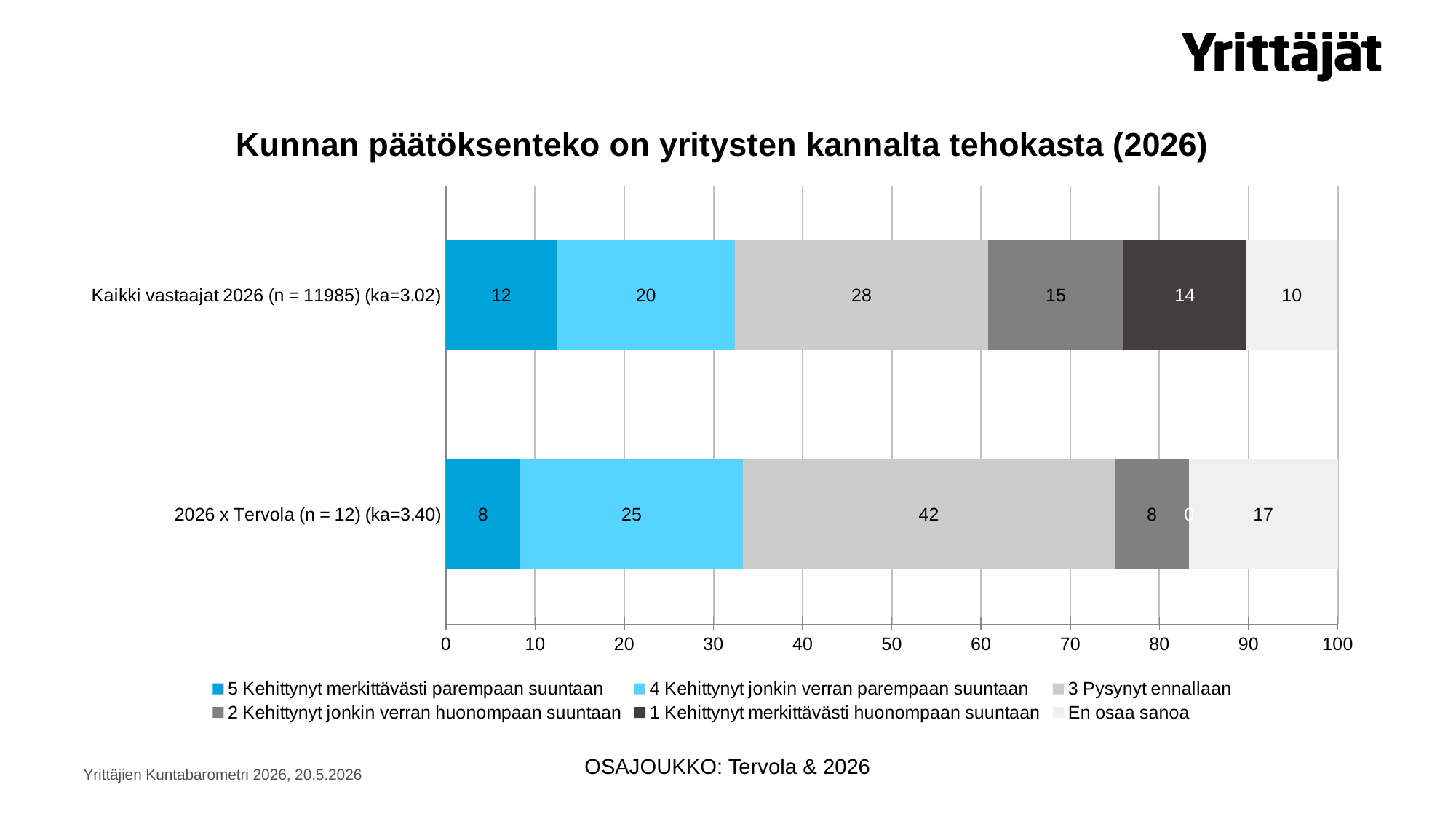
What is the title of the chart? Kunnan päätöksenteko on yritysten kannalta tehokasta (2026) Which segment is the largest in the "2026 x Tervola (n = 12) (ka=3.40)" bar? 3 Pysynyt ennallaan How many categories (bars) does the chart show? 2 What is the value of "3 Pysynyt ennallaan" for "2026 x Tervola (n = 12) (ka=3.40)"? 42 What is the value of "1 Kehittynyt merkittävästi huonompaan suuntaan" for "Kaikki vastaajat 2026 (n = 11985) (ka=3.02)"? 14 What kind of chart is shown on the slide? Stacked bar chart What is the difference between the "3 Pysynyt ennallaan" values for "2026 x Tervola (n = 12) (ka=3.40)" and "Kaikki vastaajat 2026 (n = 11985) (ka=3.02)"? 14 How many series does the legend list? 6 What is the total of the stacked bar for "Kaikki vastaajat 2026 (n = 11985) (ka=3.02)"? 99 What is the value of "5 Kehittynyt merkittävästi parempaan suuntaan" for "Kaikki vastaajat 2026 (n = 11985) (ka=3.02)"? 12 What is the value of "En osaa sanoa" for "2026 x Tervola (n = 12) (ka=3.40)"? 17 Which category has the larger value for "4 Kehittynyt jonkin verran parempaan suuntaan"? 2026 x Tervola (n = 12) (ka=3.40)